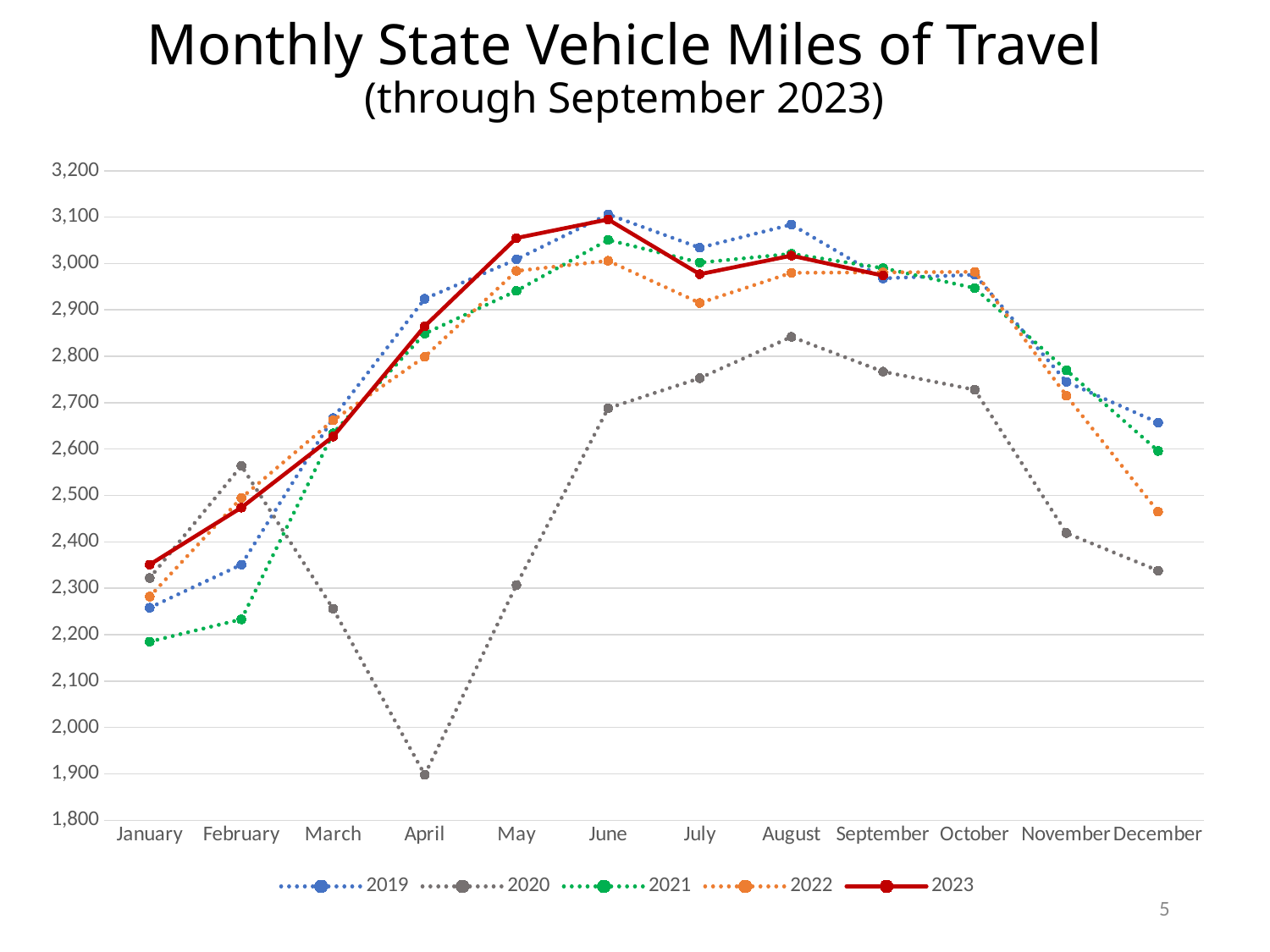
Does the 2020 series rise or fall from February to April? fall What kind of chart is shown on the slide? line chart Is the 2022 value for December greater or less than 2,500? less In July, which series has the larger value, 2020 or 2023? 2023 Which series is drawn as a solid line rather than a dotted line? 2023 How many months are shown along the x axis? 12 In which month does the 2020 series reach its highest value? August In which month does the 2023 series reach its lowest value? January Is the 2020 value for April greater or less than 2,000? less In which month does the 2020 series reach its lowest value? April How many series does the legend list? 5 Is the 2023 value for June greater or less than 3,000? greater